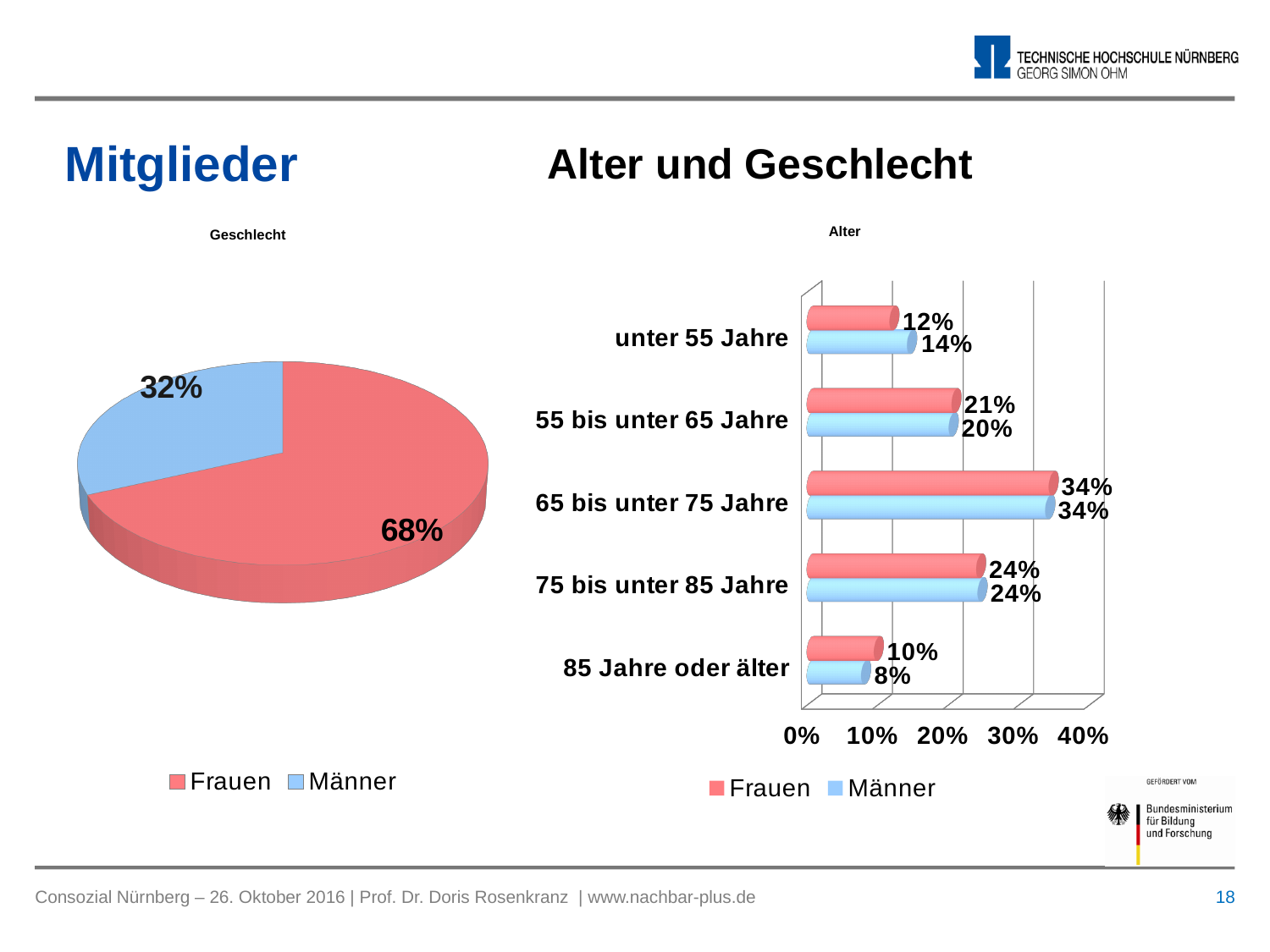
In the 'Geschlecht' pie chart, what share is shown for Männer? 32% How many series does the legend of the 'Alter' chart list? 2 In the 'Alter' chart, which age category has the lowest value for Männer? 85 Jahre oder älter In the 'Geschlecht' pie chart, what share is shown for Frauen? 68% In the 'Alter' chart, which age category has the highest value for Frauen? 65 bis unter 75 Jahre What kind of chart is the 'Geschlecht' chart on the left? Pie chart What kind of chart is the 'Alter' chart on the right? Bar chart In the 'Alter' chart, what is the value for Männer in the 'unter 55 Jahre' category? 14% In the 'Alter' chart, what is the value for Frauen in the '85 Jahre oder älter' category? 10% In the 'Alter' chart, what is the difference between Frauen and Männer in the 'unter 55 Jahre' category? 2% In the 'Alter' chart, which is larger in the '55 bis unter 65 Jahre' category, Frauen or Männer? Frauen How many age categories does the 'Alter' chart show? 5